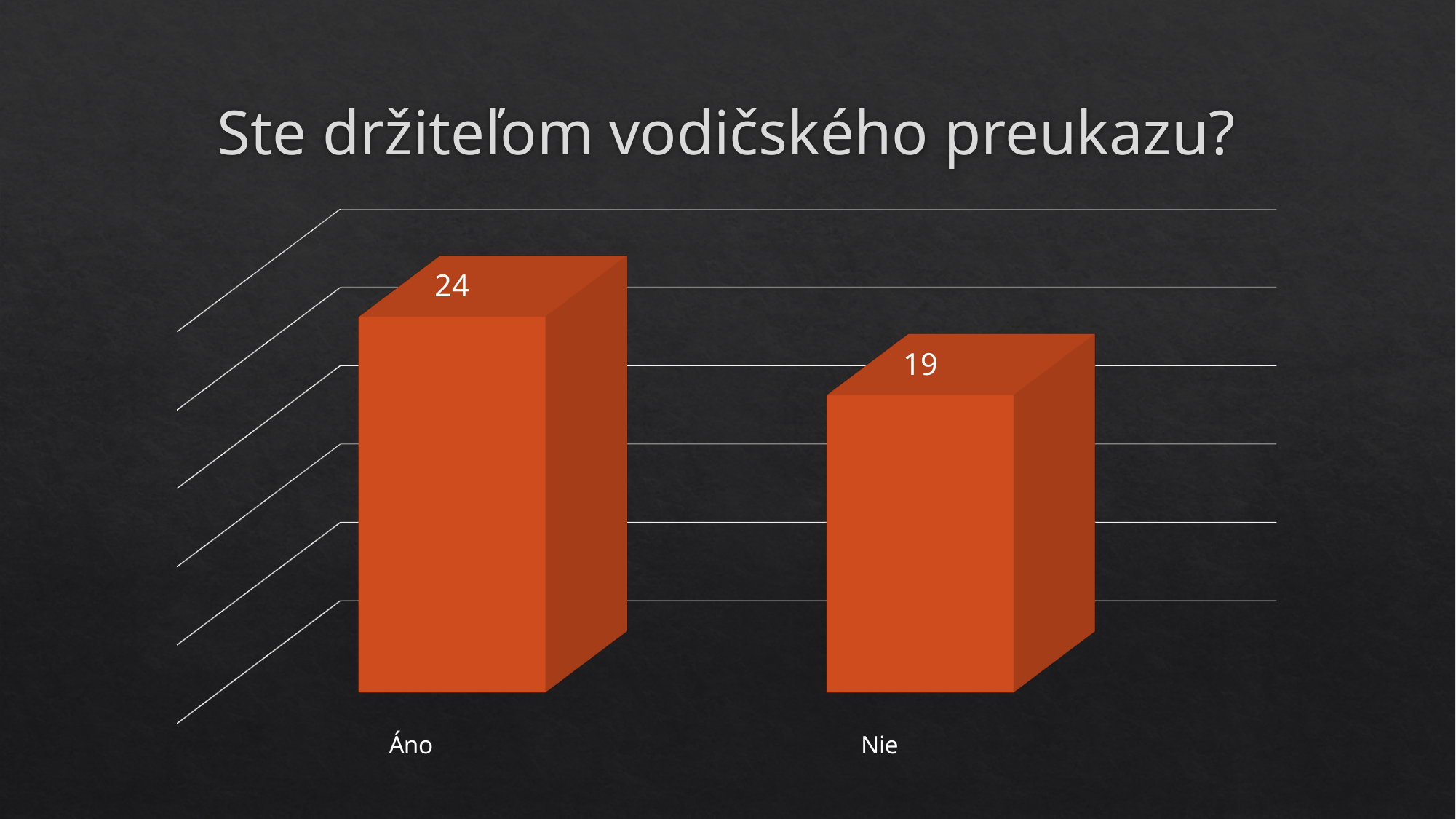
Which category has the lowest value? Nie What is the difference between the values for Áno and Nie? 5 What kind of chart is shown on the slide? Bar chart What is the total of the values for Áno and Nie? 43 What is the value for Nie? 19 What is the value for Áno? 24 Which category has the highest value? Áno Which is larger, the value for Áno or the value for Nie? Áno How many categories are shown in the chart? 2 What colour are the bars in the chart? Orange What is the title of the chart? Ste držiteľom vodičského preukazu?